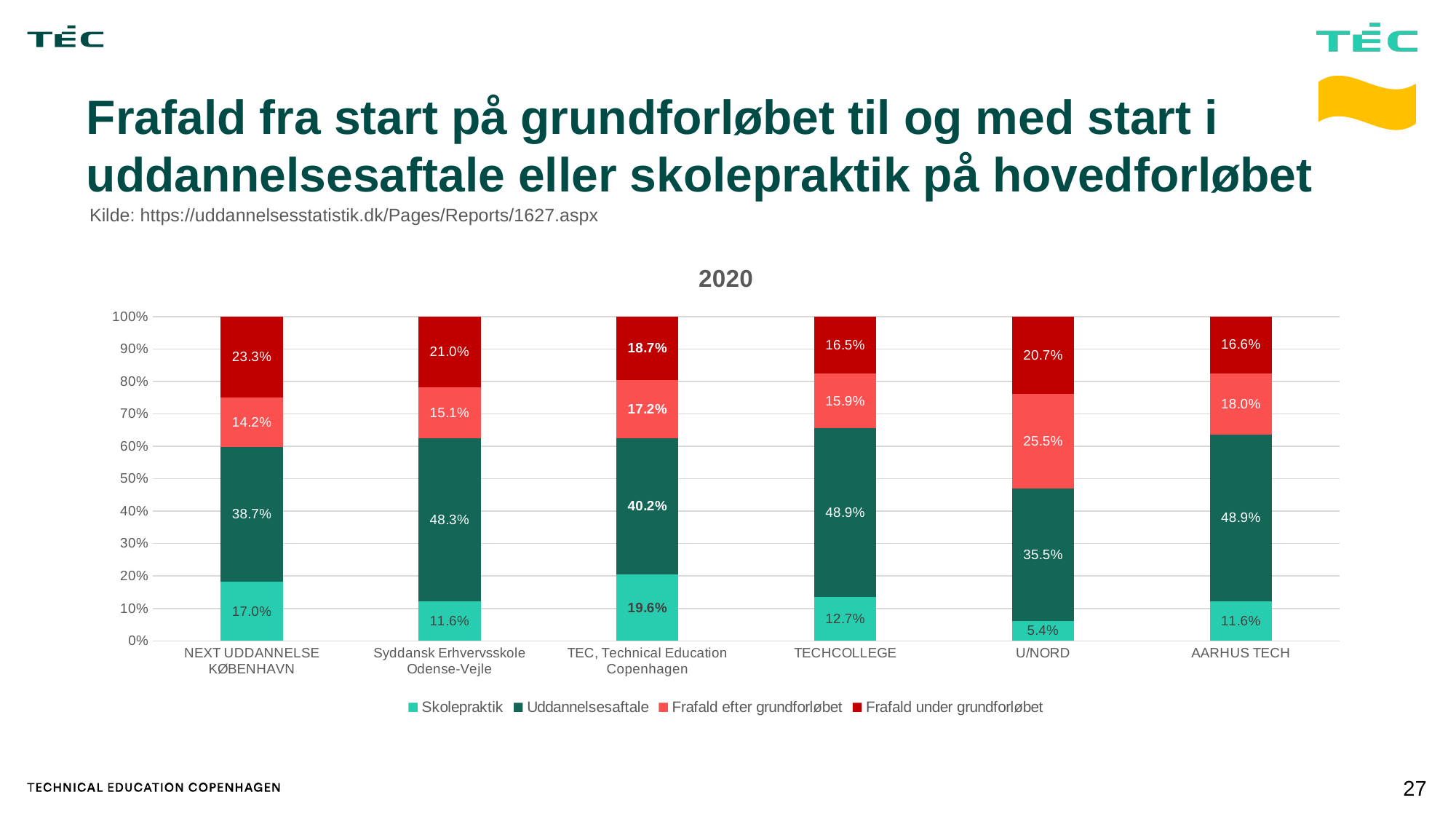
Which school has the highest Skolepraktik share? TEC, Technical Education Copenhagen What is the Uddannelsesaftale value for U/NORD? 35.5% What kind of chart is shown on the slide? Stacked bar chart What is the difference between the Uddannelsesaftale values for TECHCOLLEGE and NEXT UDDANNELSE KØBENHAVN? 10.2% How many series does the legend list? 4 What is the Frafald efter grundforløbet value for AARHUS TECH? 18.0% Which school has the highest Frafald under grundforløbet share? NEXT UDDANNELSE KØBENHAVN Which school has the lowest Skolepraktik share? U/NORD Which is larger: the Frafald efter grundforløbet value for U/NORD or for TECHCOLLEGE? U/NORD How many schools are shown on the x axis? 6 What is the Skolepraktik value for TEC, Technical Education Copenhagen? 19.6% What is the Frafald under grundforløbet value for Syddansk Erhvervsskole Odense-Vejle? 21.0%